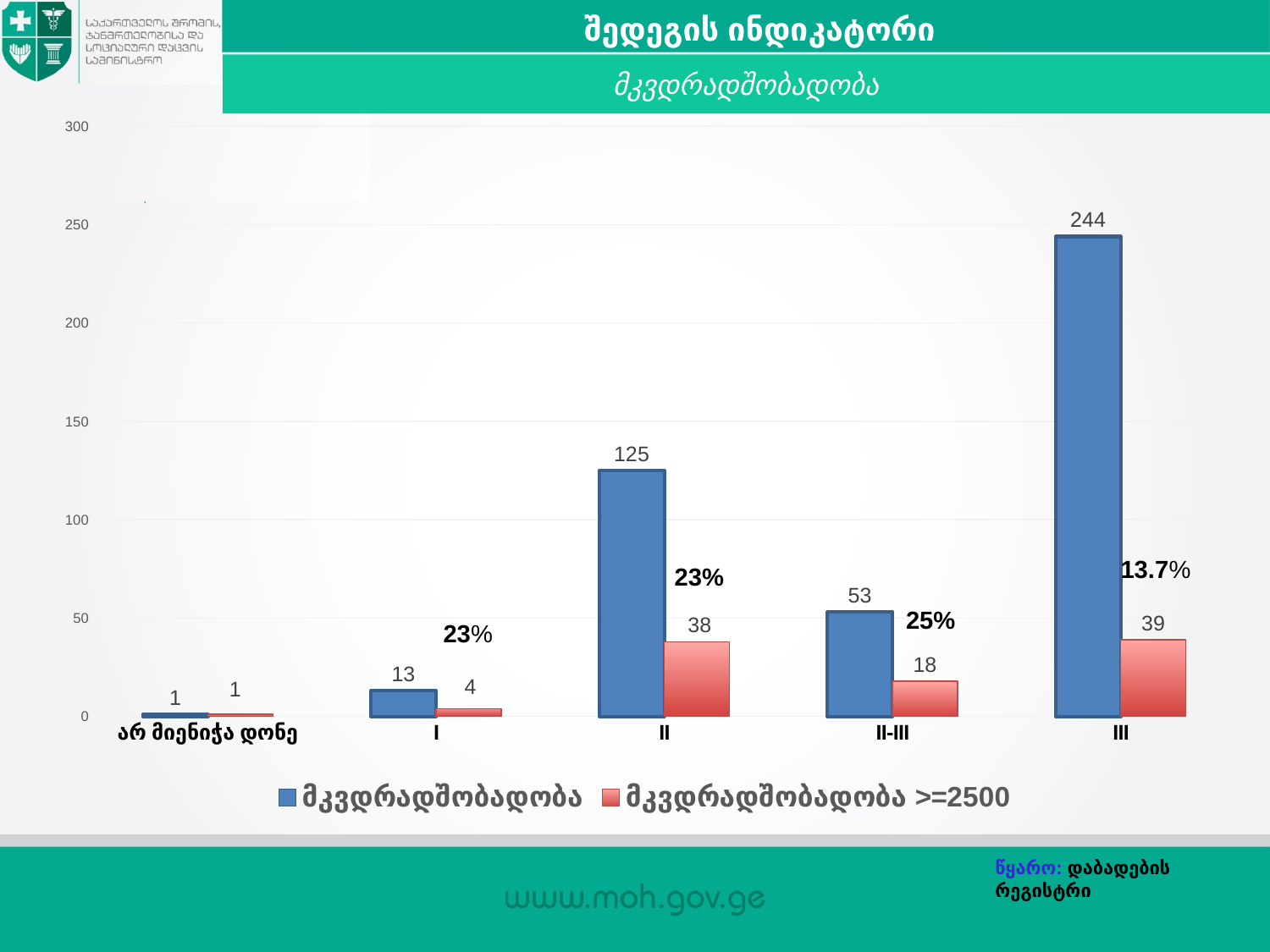
How many categories are shown on the x axis? 5 What kind of chart is shown on the slide? bar chart What is the value of მკვდრადშობადობა >=2500 for category II? 38 What is the value of მკვდრადშობადობა >=2500 for category I? 4 Which category has the lowest value for მკვდრადშობადობა >=2500? არ მიენიჭა დონე Which category has the highest value for მკვდრადშობადობა? III What is the value of მკვდრადშობადობა for category III? 244 What is the difference between the მკვდრადშობადობა values for III and II? 119 Is the value of მკვდრადშობადობა for category II greater or less than 100? greater Which is larger: the მკვდრადშობადობა >=2500 value for III or for II? III What is the value of მკვდრადშობადობა for category II-III? 53 How many series does the legend list? 2